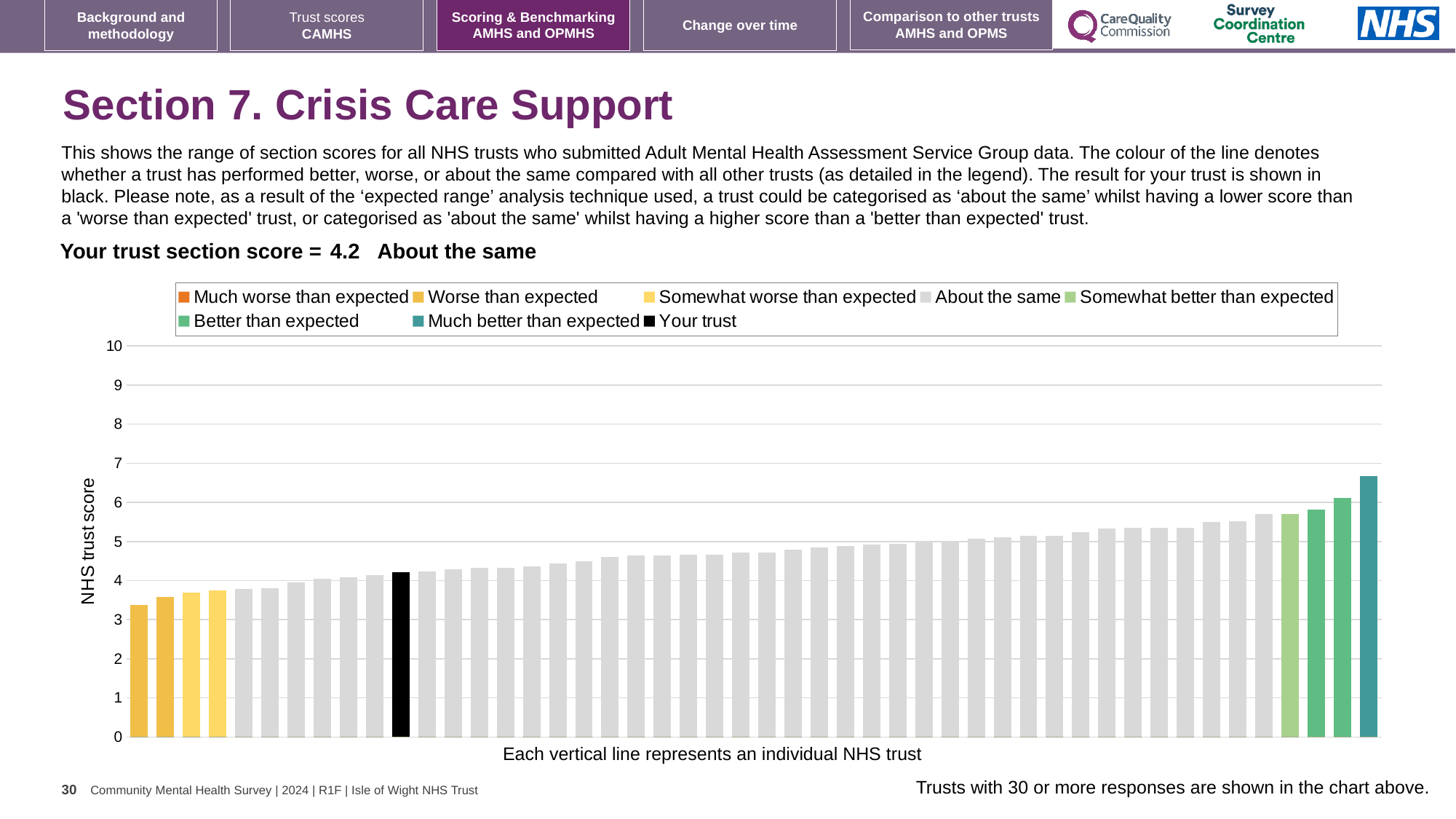
Is the value of the lowest bar greater or less than 4? less What kind of chart is shown on the slide? bar chart Is the value of the lowest bar greater or less than 3? greater Is the value of the highest bar greater or less than 7? less What is the section score for your trust shown on the slide? 4.2 How many entries does the chart legend list? 8 Do the bar values rise or fall from left to right along the x axis? rise What is the label on the vertical axis of the chart? NHS trust score Which performance category is your trust placed in for this section? About the same Which legend category does the highest bar on the chart belong to? Much better than expected